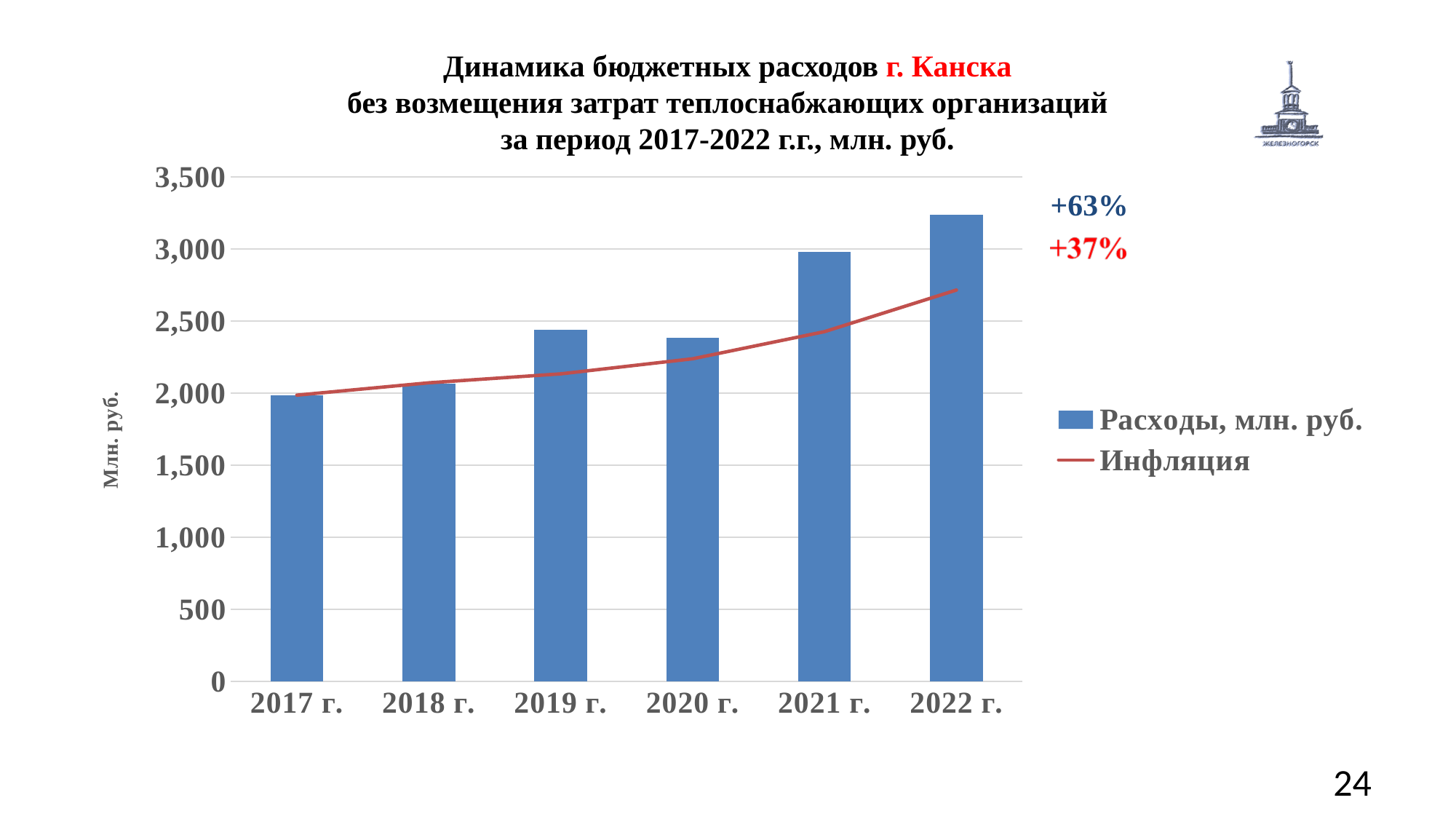
What percentage growth figures are annotated to the right of the chart? +63% and +37% How many years are shown on the x axis of the chart? 6 What kind of chart is shown on the slide? Bar chart with a line Do the Расходы bars generally rise or fall from 2017 г. to 2022 г.? Rise Is the value of Расходы for 2017 г. greater or less than 1,500? greater What are the two series named in the chart legend? Расходы, млн. руб. and Инфляция Is the value of Расходы for 2019 г. greater or less than 2,500? less Is the value of Расходы for 2021 г. greater or less than 2,500? greater Which year has the larger Расходы bar, 2019 г. or 2021 г.? 2021 г. Which year has the highest bar for Расходы, млн. руб.? 2022 г. How many series does the chart legend list? 2